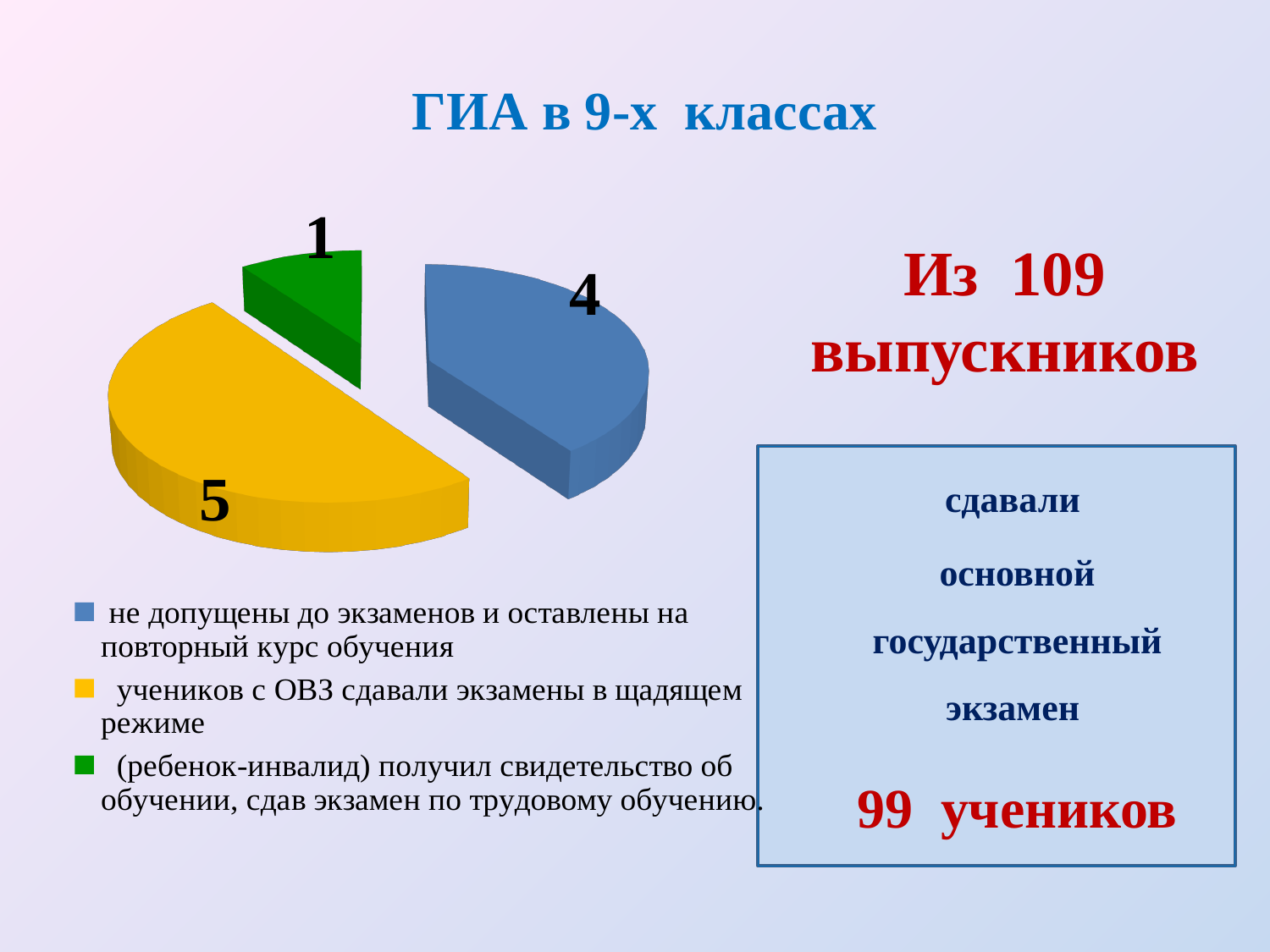
What kind of chart is shown on the slide? pie chart What is the title of the slide containing the pie chart? ГИА в 9-х классах What is the value of the yellow slice (учеников с ОВЗ сдавали экзамены в щадящем режиме)? 5 Which category has the smallest slice in the pie chart? (ребенок-инвалид) получил свидетельство об обучении, сдав экзамен по трудовому обучению How many entries does the legend of the pie chart list? 3 What is the value of the green slice (ребенок-инвалид, получил свидетельство об обучении)? 1 What is the difference between the yellow slice value and the blue slice value? 1 How many slices does the pie chart have? 3 What is the value of the blue slice (не допущены до экзаменов и оставлены на повторный курс обучения)? 4 Which category has the largest slice in the pie chart? учеников с ОВЗ сдавали экзамены в щадящем режиме Which is larger: the blue slice or the green slice? the blue slice What share of the pie does the yellow slice (value 5) represent? 50%